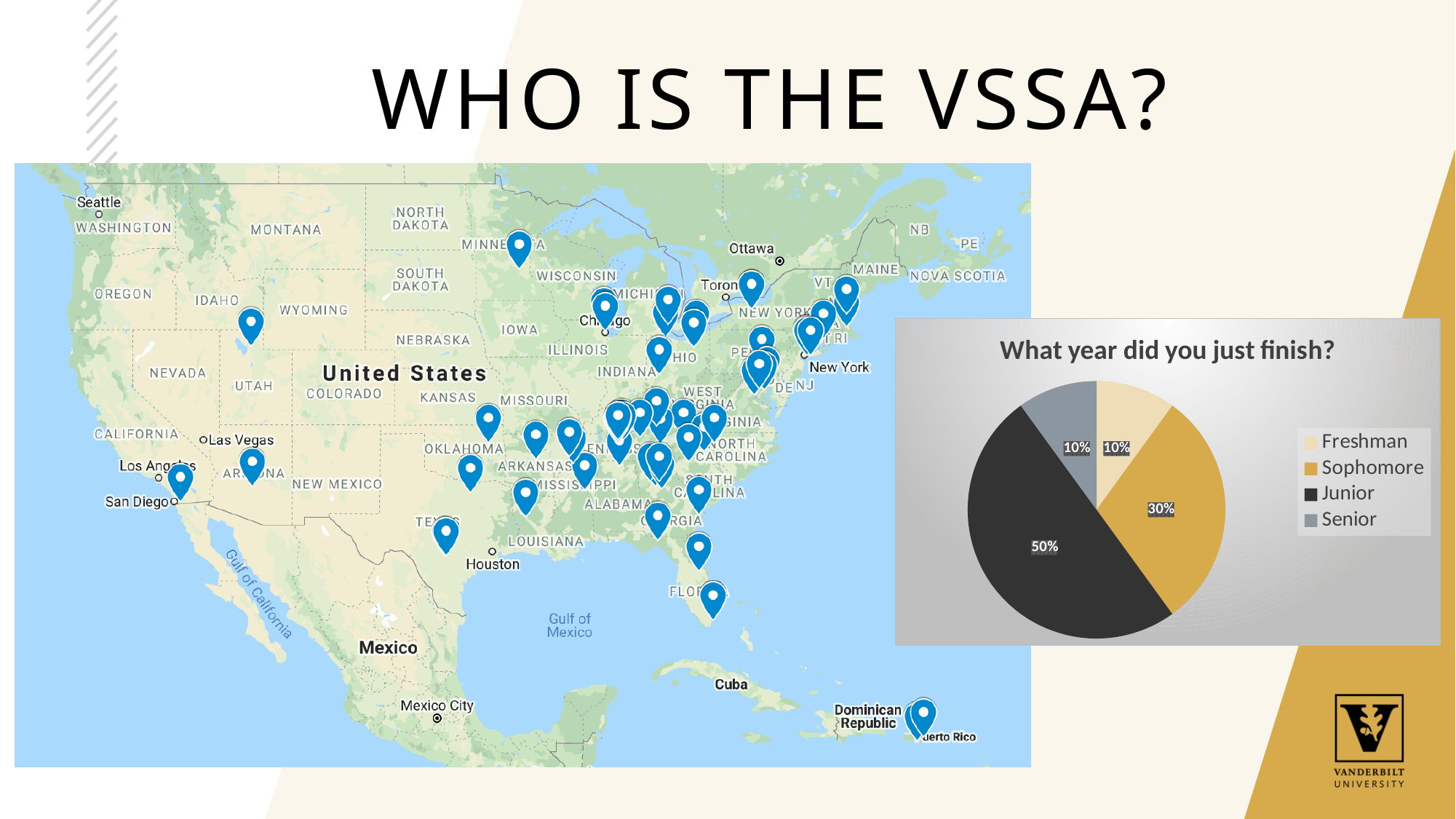
What share of the pie chart is Junior? 50% What colour is the Sophomore slice in the pie chart? gold Which category has the largest slice in the pie chart? Junior What kind of chart is shown on the right of the slide? pie chart What share of the pie chart is Sophomore? 30% Which is larger in the pie chart, Sophomore or Freshman? Sophomore How many categories does the pie chart's legend list? 4 What share of the pie chart is Senior? 10% What is the title of the pie chart? What year did you just finish? What is the difference between the Junior and Sophomore shares in the pie chart? 20% What share of the pie chart is Freshman? 10% What is the combined share of Freshman and Senior in the pie chart? 20%